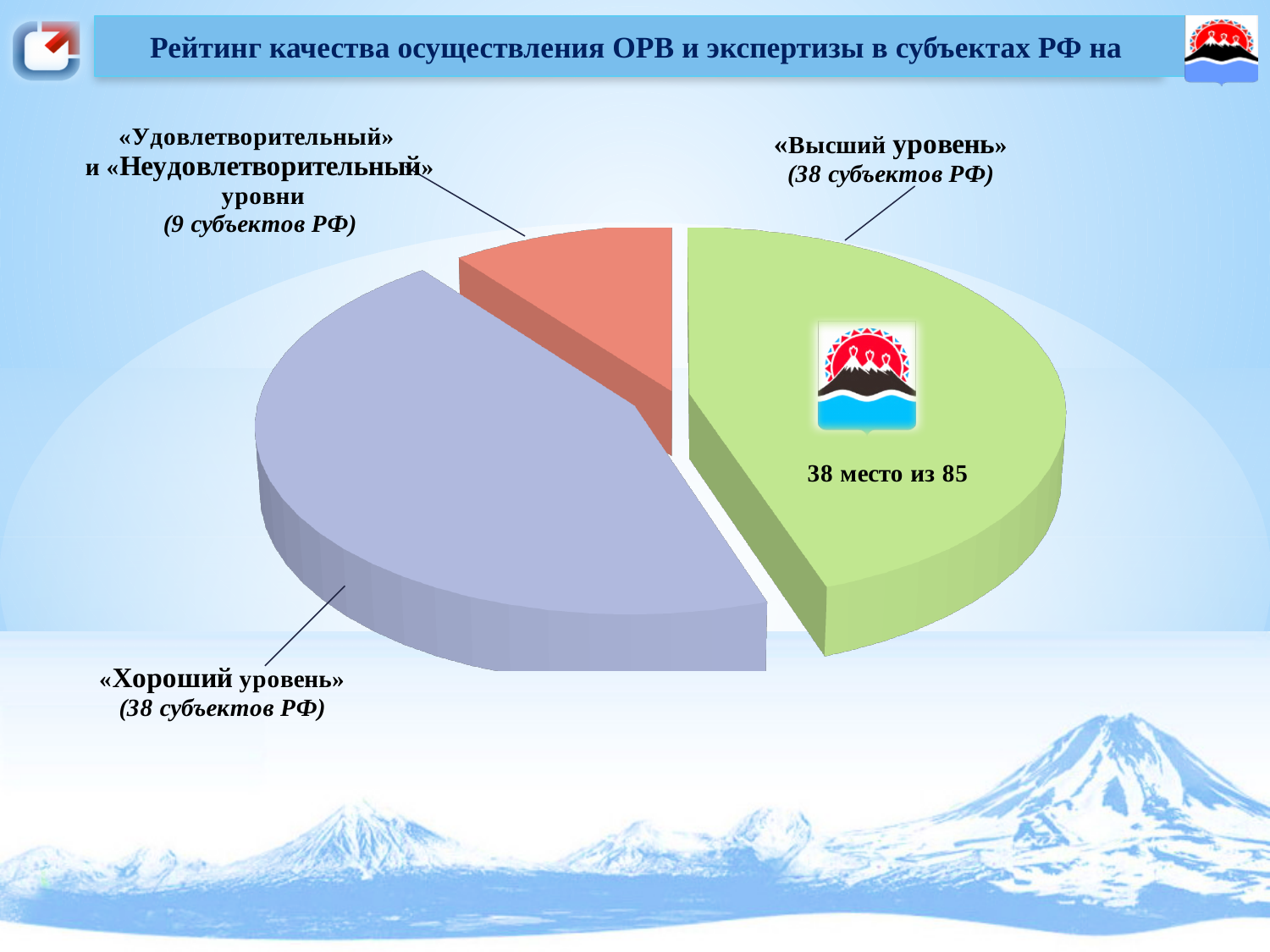
What colour is the «Высший уровень» slice? Green What kind of chart is shown on the slide? Pie chart How many slices does the pie chart have? 3 How many subjects of the RF are in the «Высший уровень» category? 38 субъектов РФ What is the total number of subjects of the RF across all slices of the pie chart? 85 What is the difference in the number of subjects between «Хороший уровень» and «Удовлетворительный» и «Неудовлетворительный» уровни? 29 Which category has more subjects: «Высший уровень» or «Удовлетворительный» и «Неудовлетворительный» уровни? «Высший уровень» Which category has the smallest number of subjects of the RF? «Удовлетворительный» и «Неудовлетворительный» уровни What place out of 85 is stated on the slide? 38 место из 85 How many subjects of the RF are in the «Хороший уровень» category? 38 субъектов РФ What colour is the «Хороший уровень» slice? Lavender (light purple) How many subjects of the RF are in the «Удовлетворительный» и «Неудовлетворительный» уровни category? 9 субъектов РФ